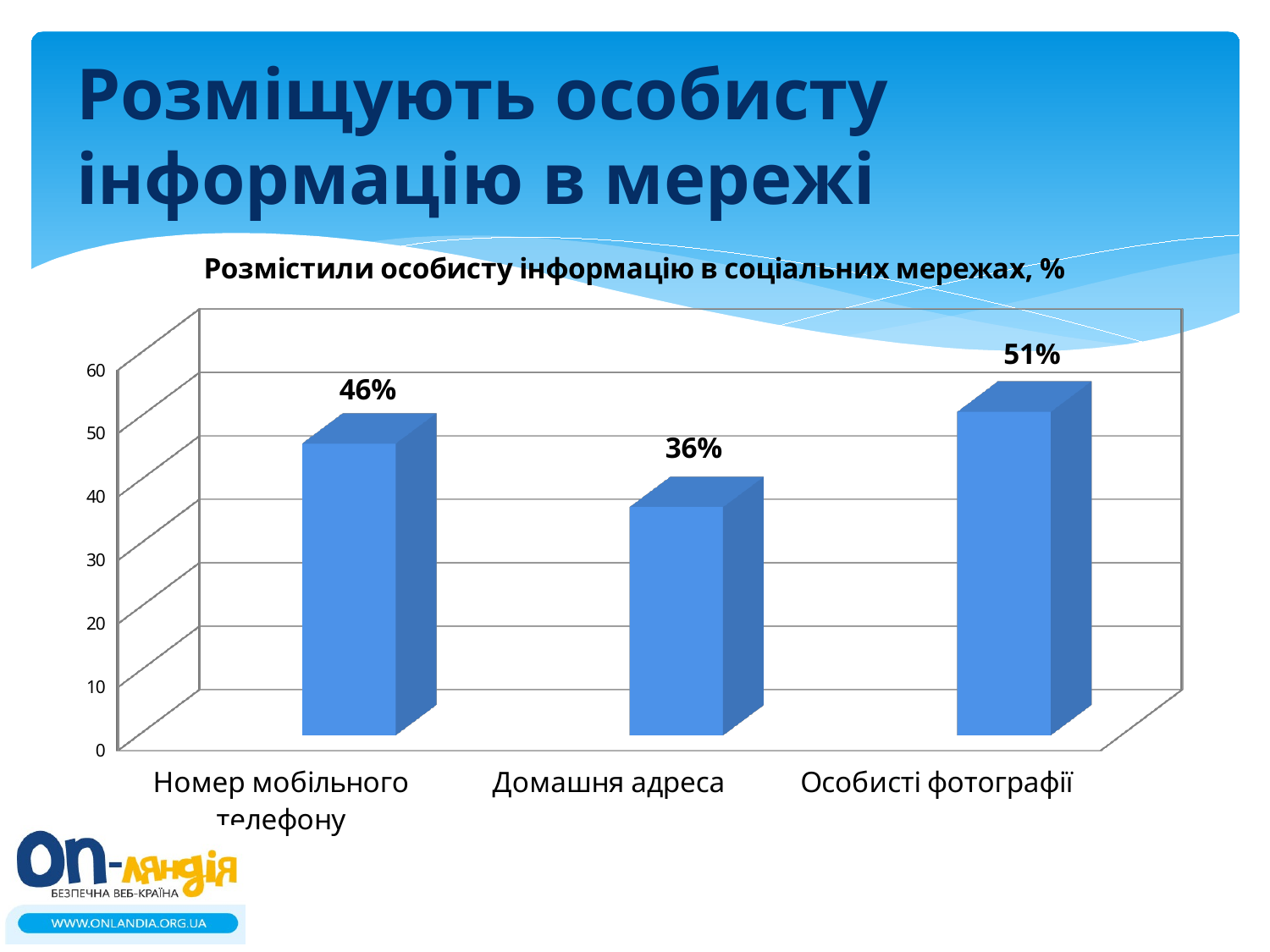
Which category has the lowest value? Домашня адреса Which category has the highest value? Особисті фотографії What is the difference between the values for Особисті фотографії and Домашня адреса? 15% What kind of chart is shown on the slide? bar chart Is the value for Домашня адреса greater or less than 40? less What is the difference between the values for Номер мобільного телефону and Домашня адреса? 10% What is the value for Особисті фотографії? 51% What is the value for Домашня адреса? 36% How many categories are shown in the chart? 3 What is the value for Номер мобільного телефону? 46% What is the title of the chart? Розмістили особисту інформацію в соціальних мережах, % Which is larger, the value for Номер мобільного телефону or the value for Особисті фотографії? Особисті фотографії